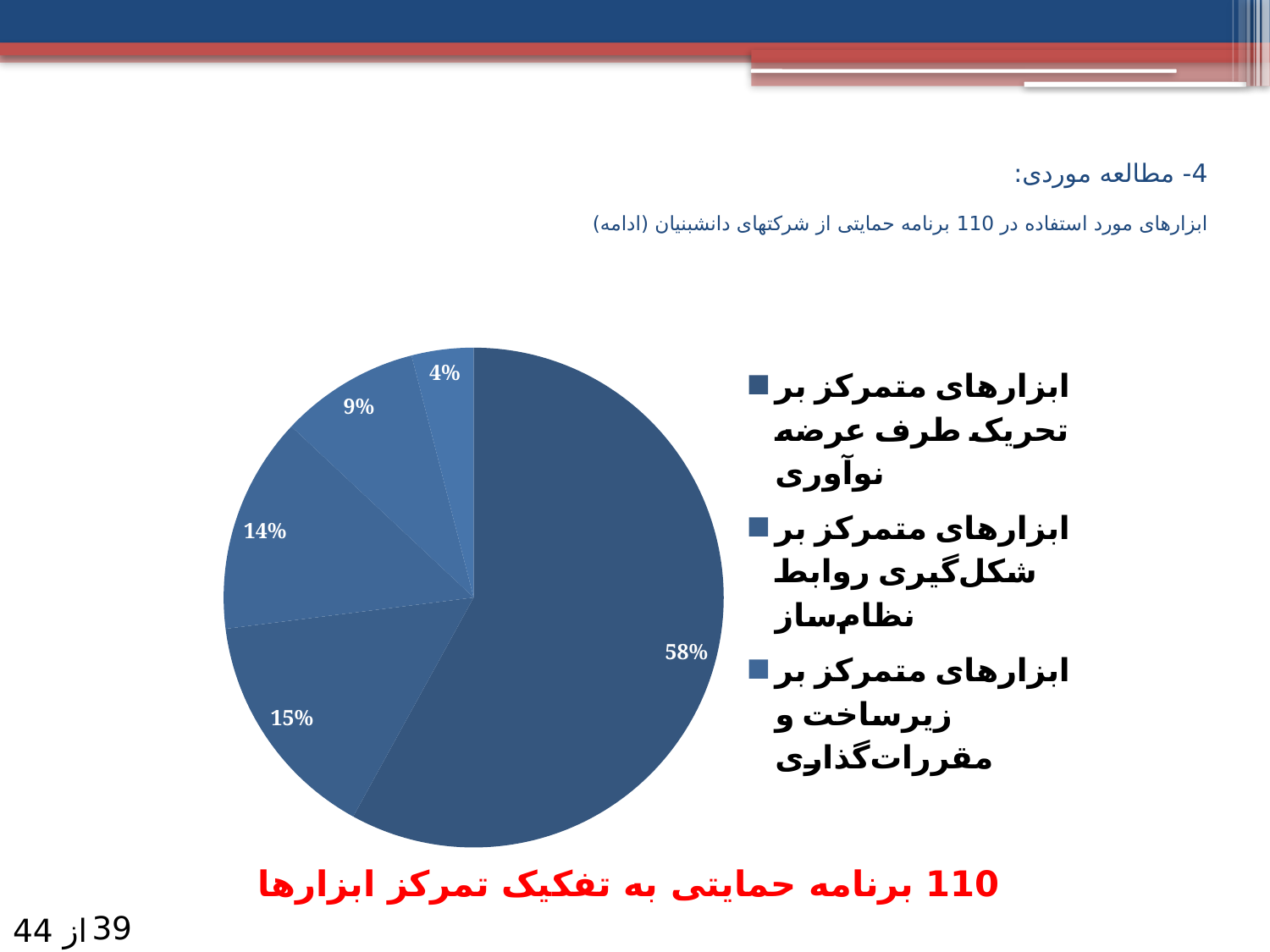
What is the percentage of the smallest slice in the pie chart? 4% What share of the pie does the largest slice take? 58% What kind of chart is shown on the slide? pie chart What is the difference in percentage points between the 15% slice and the 14% slice? 1 What is the title written below the pie chart? 110 برنامه حمایتی به تفکیک تمرکز ابزارها What is the percentage of the largest slice in the pie chart? 58% Which is larger, the 9% slice or the 14% slice? the 14% slice What do the five slice percentages in the pie chart add up to? 100% How many entries does the legend of the pie chart list? 3 How many slices does the pie chart have? 5 Is the largest slice of the pie chart greater or less than 50%? greater What is the difference in percentage points between the largest slice (58%) and the 15% slice? 43